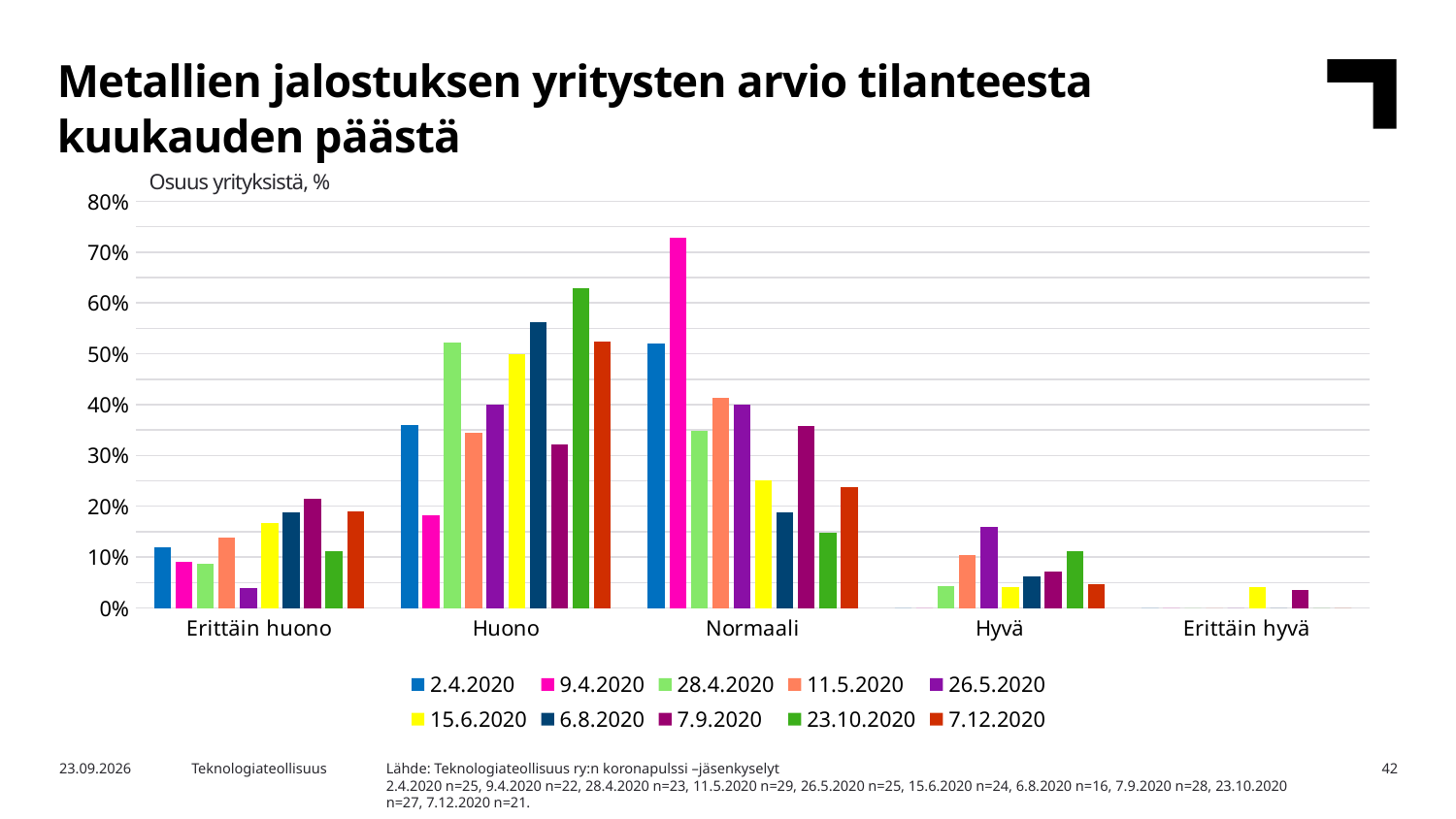
Is the value for 9.4.2020 in the Normaali category greater or less than 70%? greater In the Normaali category, which is larger: the value for 2.4.2020 or for 28.4.2020? 2.4.2020 What kind of chart is shown on the slide? Bar chart Is the value for 23.10.2020 in the Huono category greater or less than 60%? greater Is the value for 26.5.2020 in the Erittäin huono category greater or less than 10%? less In the Huono category, which series has the highest value? 23.10.2020 In the Huono category, which is larger: the value for 2.4.2020 or for 9.4.2020? 2.4.2020 How many categories are shown on the x axis? 5 How many series does the legend list? 10 What is the label shown above the y axis of the chart? Osuus yrityksistä, % In the Hyvä category, which series has the highest value? 26.5.2020 In the Normaali category, which series has the highest value? 9.4.2020